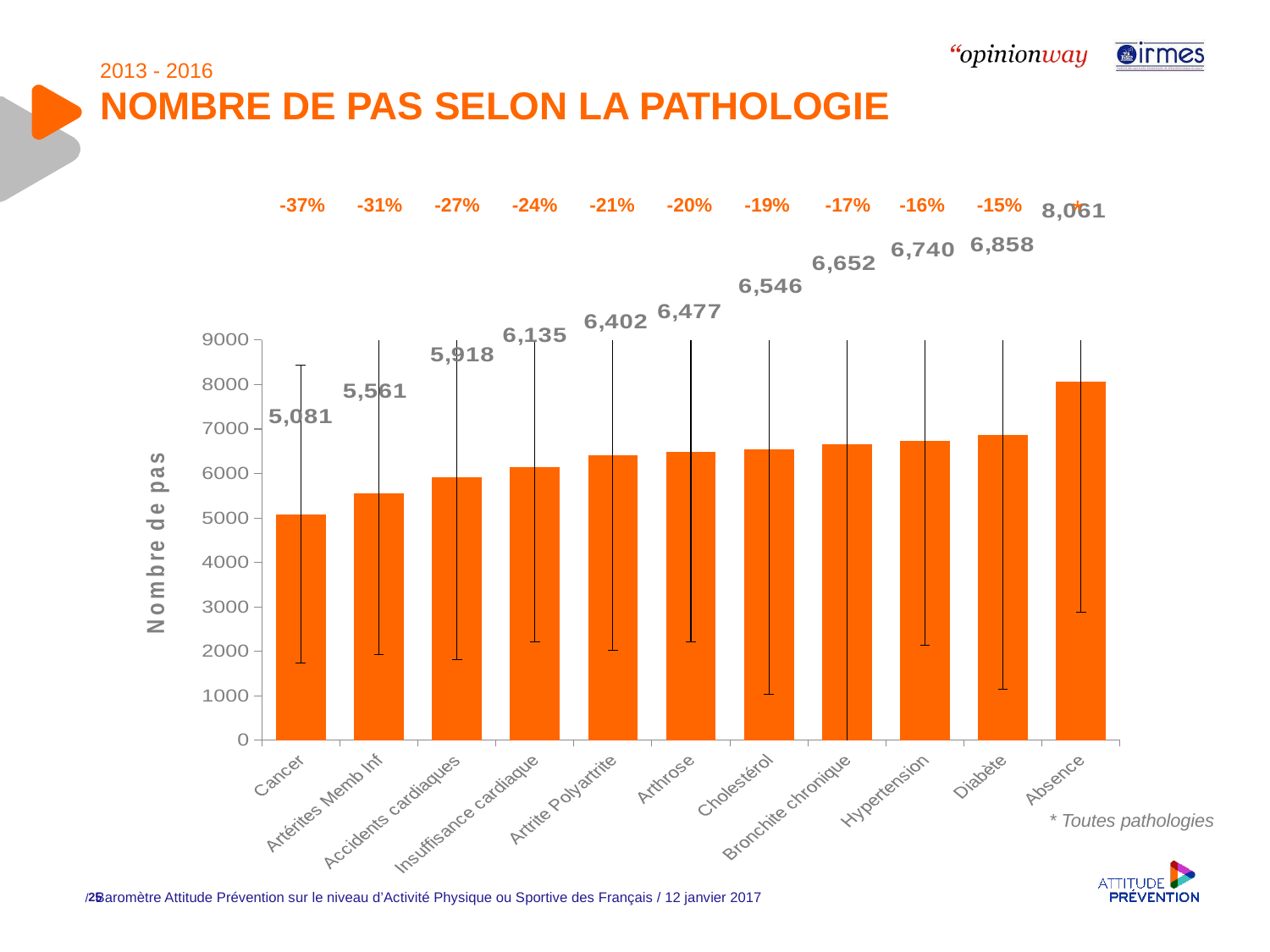
What is the number of steps for Hypertension? 6,740 How many pathology categories are shown on the x axis? 11 What type of chart is shown on the slide? bar chart What percentage is shown above the Cholestérol bar? -19% What is the difference in number of steps between Diabète and Arthrose? 381 Is the value for Artérites Memb Inf greater or less than 6000? less What is the difference in number of steps between Absence and Cancer? 2,980 Which has more steps, Accidents cardiaques or Insuffisance cardiaque? Insuffisance cardiaque What is the number of steps for Absence (toutes pathologies)? 8,061 Which category has the highest number of steps? Absence Which pathology has the lowest number of steps? Cancer What is the number of steps (nombre de pas) for Cancer? 5,081